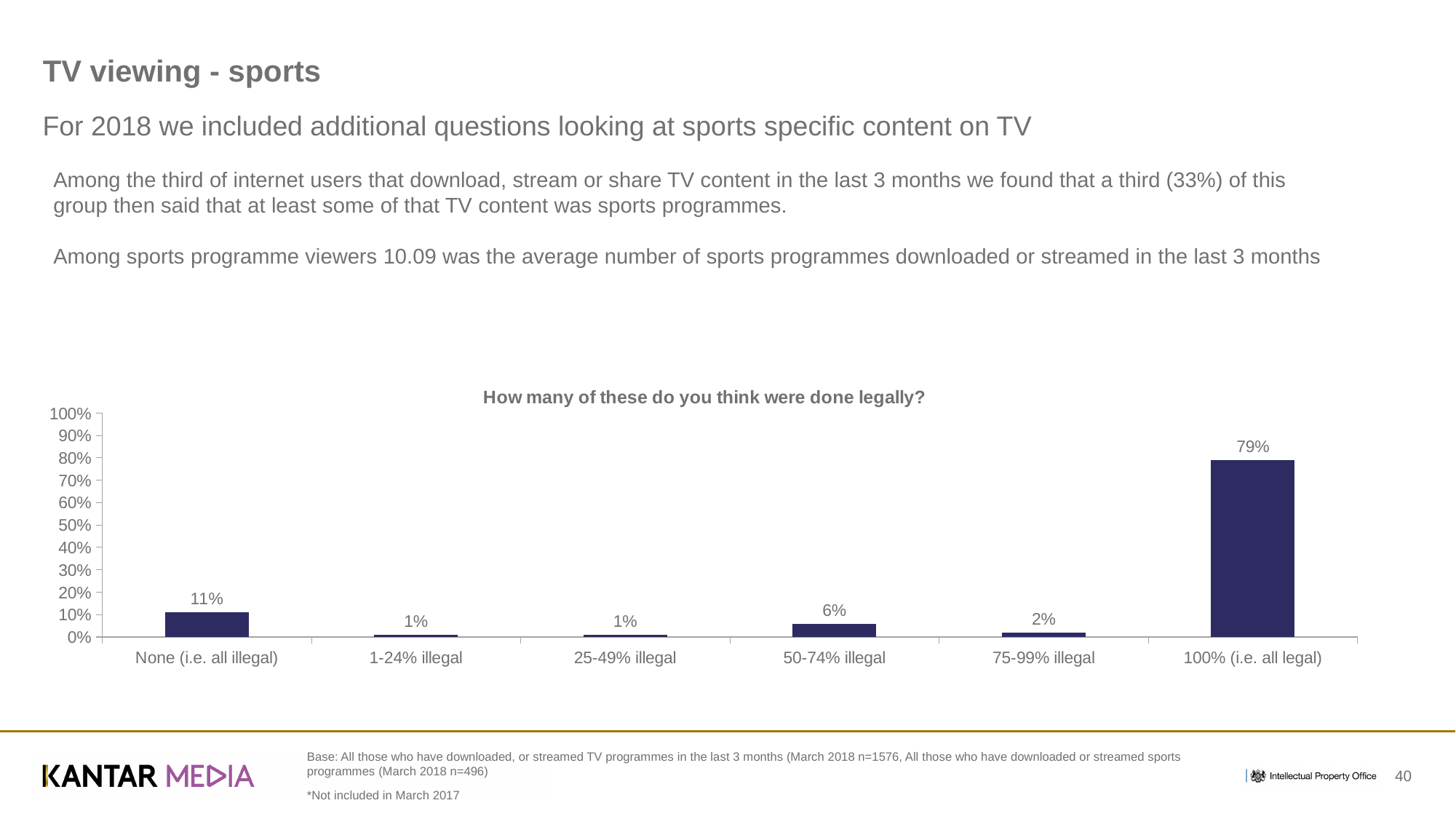
Which is larger, the value for '50-74% illegal' or the value for '75-99% illegal'? 50-74% illegal Which category has the highest value? 100% (i.e. all legal) Is the value for '100% (i.e. all legal)' greater or less than 70%? greater What is the difference between the values for 'None (i.e. all illegal)' and '50-74% illegal'? 5% What is the difference between the values for '100% (i.e. all legal)' and 'None (i.e. all illegal)'? 68% What kind of chart is shown on the slide? bar chart What is the title of the chart? How many of these do you think were done legally? What is the value for '75-99% illegal'? 2% What is the value for '50-74% illegal'? 6% What is the value for '100% (i.e. all legal)'? 79% What is the value for 'None (i.e. all illegal)'? 11% How many categories are shown on the x axis? 6